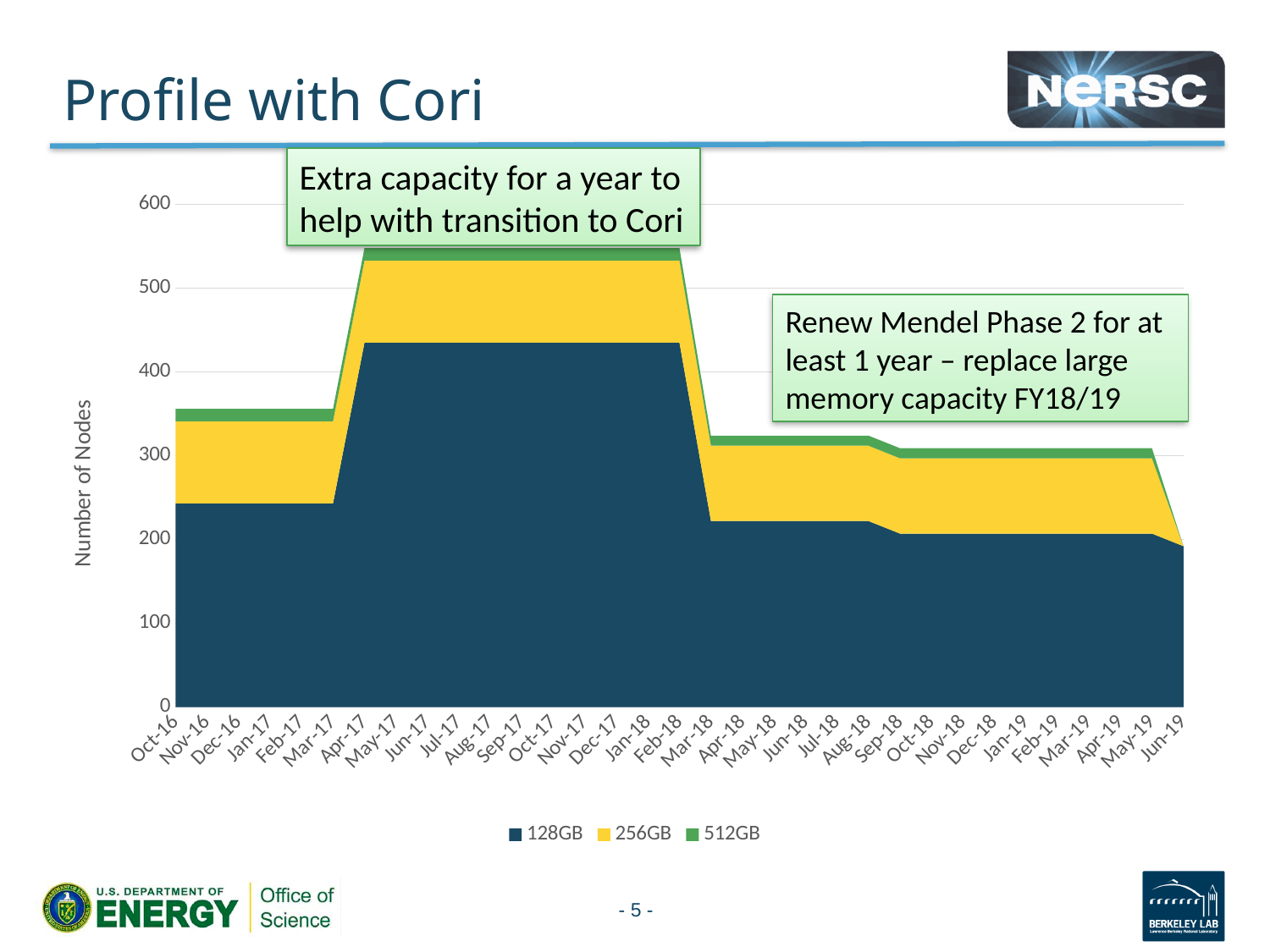
What kind of chart is shown on the slide? Stacked area chart How many months are shown along the x axis, from Oct-16 to Jun-19? 33 Does the total number of nodes rise or fall from Feb-18 to Mar-18? Fall Is the value for the 128GB series in May-17 greater or less than 400? greater Which series contributes the most nodes in Oct-16, 128GB or 512GB? 128GB Is the total number of nodes in Jun-17 greater or less than 500? greater Is the value for the 128GB series in Oct-16 greater or less than 300? less Does the total number of nodes rise or fall from Mar-17 to Apr-17? Rise What is the label on the vertical axis of the chart? Number of Nodes How many series does the chart legend list? 3 What are the three series named in the chart legend? 128GB, 256GB, 512GB